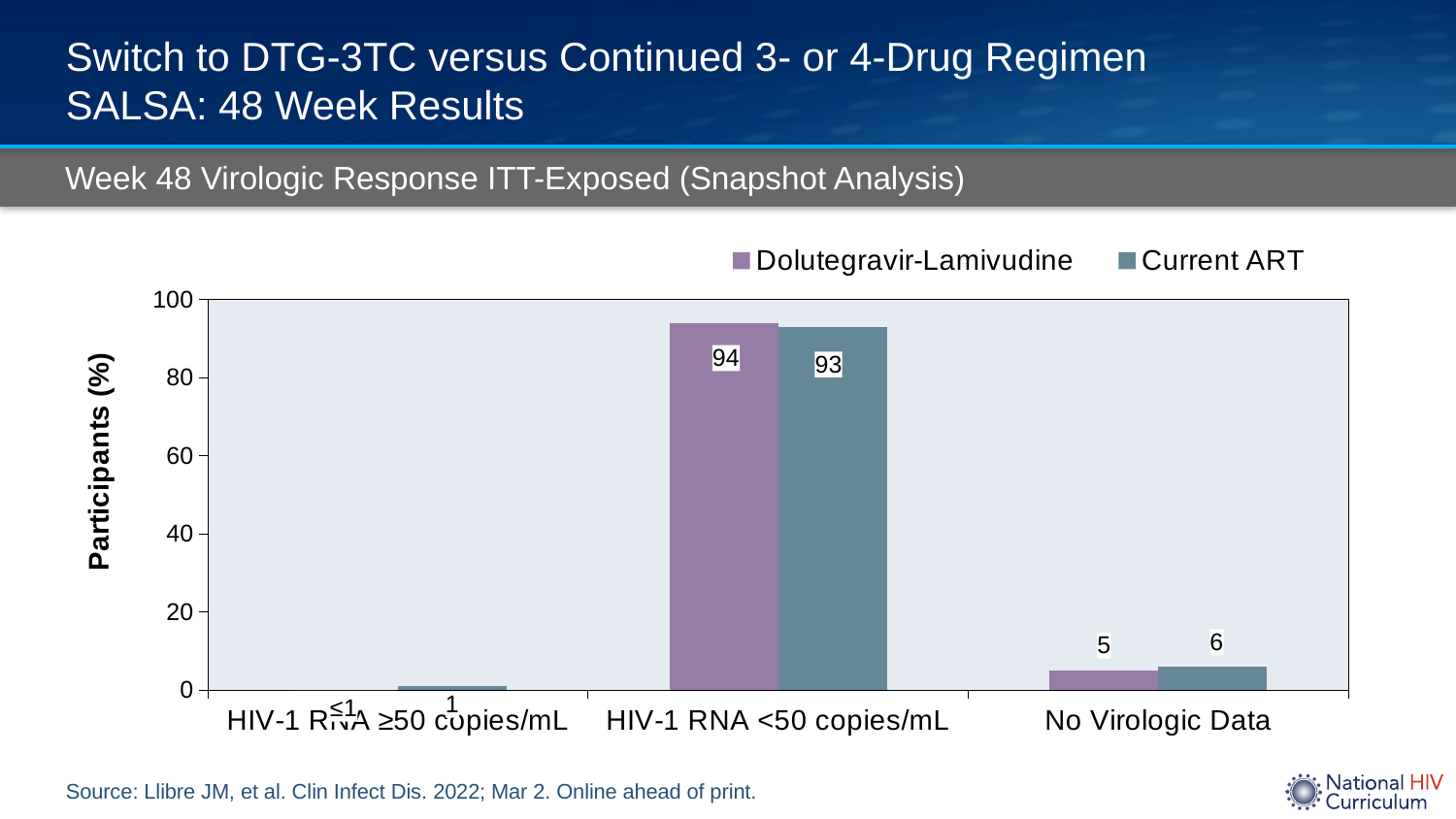
How many series does the legend list? 2 What kind of chart is shown on the slide? Bar chart What percentage of participants in the Current ART group had HIV-1 RNA <50 copies/mL? 93 For No Virologic Data, which group has the larger value, Dolutegravir-Lamivudine or Current ART? Current ART What is the value for HIV-1 RNA ≥50 copies/mL in the Current ART group? 1 What is the difference between the Dolutegravir-Lamivudine and Current ART values for HIV-1 RNA <50 copies/mL? 1 What is the value for No Virologic Data in the Dolutegravir-Lamivudine group? 5 What percentage of participants in the Dolutegravir-Lamivudine group had HIV-1 RNA <50 copies/mL? 94 What is the value for No Virologic Data in the Current ART group? 6 Which category has the highest value for the Dolutegravir-Lamivudine group? HIV-1 RNA <50 copies/mL How many categories are shown on the x axis? 3 Is the Current ART value for HIV-1 RNA <50 copies/mL greater or less than 80? greater